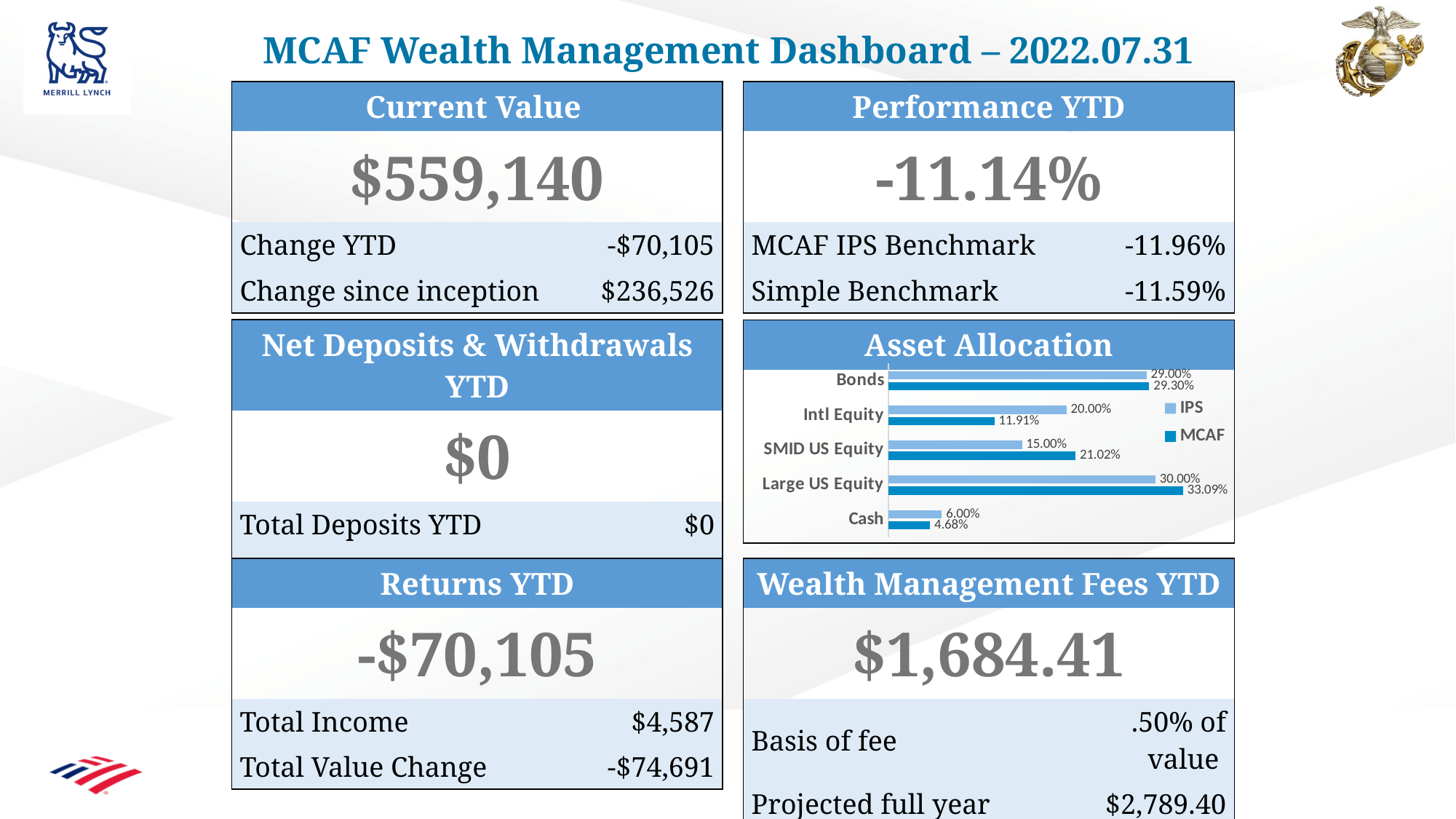
In the Asset Allocation chart, what is the MCAF value for Cash? 4.68% What type of chart is the Asset Allocation chart? Bar chart In the Asset Allocation chart, what is the difference between the MCAF and IPS values for SMID US Equity? 6.02% In the Asset Allocation chart, what is the MCAF value for Intl Equity? 11.91% In the Asset Allocation chart, what is the IPS value for Large US Equity? 30.00% In the Asset Allocation chart, which category has the lowest IPS value? Cash How many series does the legend of the Asset Allocation chart list? 2 In the Asset Allocation chart, what is the IPS value for SMID US Equity? 15.00% What are the two series named in the legend of the Asset Allocation chart? IPS and MCAF In the Asset Allocation chart, which is larger for Intl Equity: the IPS value or the MCAF value? IPS In the Asset Allocation chart, which category has the highest MCAF value? Large US Equity How many categories are shown in the Asset Allocation chart? 5